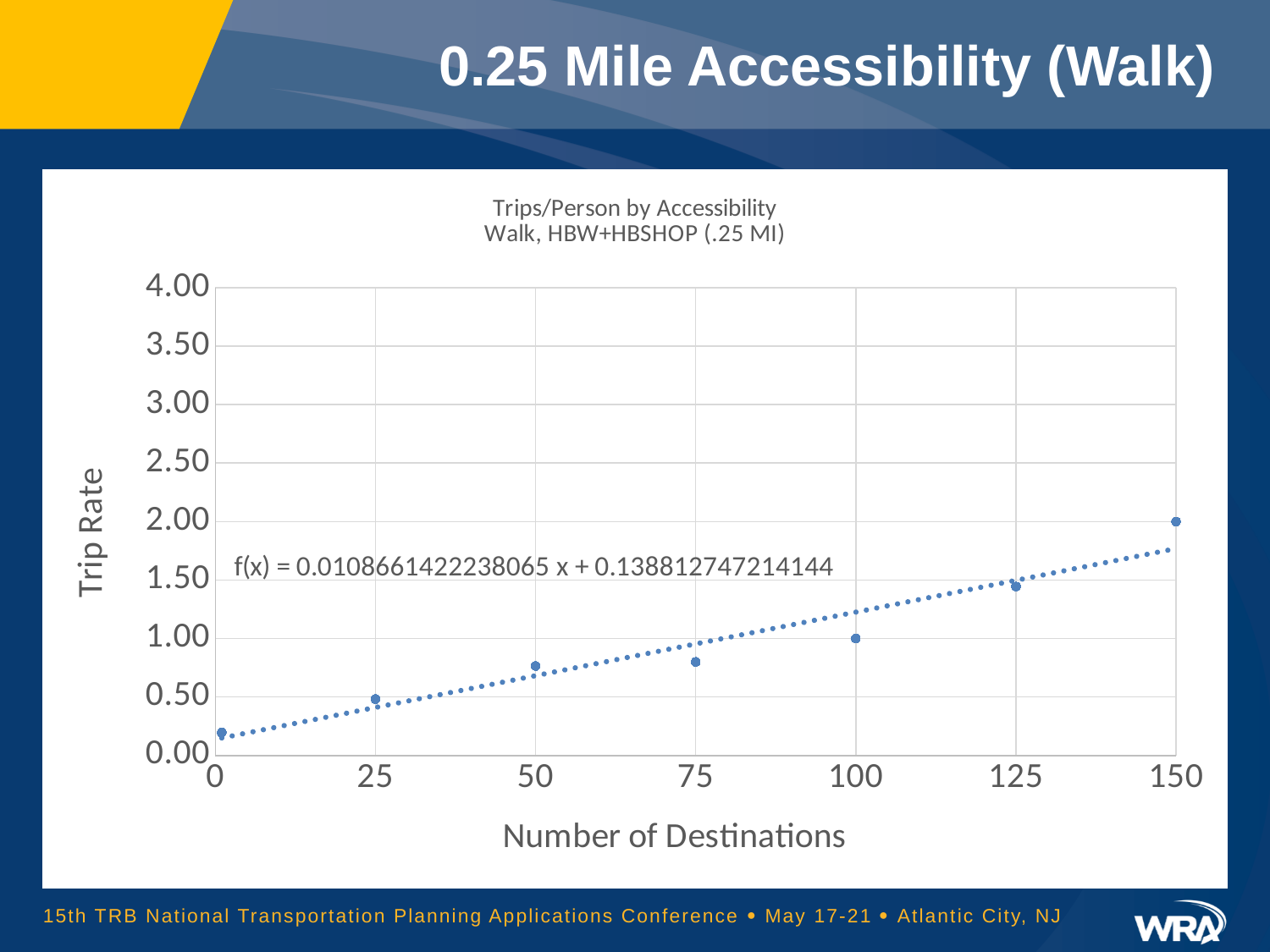
What is the title of the chart? Trips/Person by Accessibility Walk, HBW+HBSHOP (.25 MI) How many data points are plotted in the chart? 7 Is the trip rate at 0 destinations greater or less than 0.50? less Do the trip rate values rise or fall as the number of destinations increases? rise Is the trip rate at 125 destinations greater or less than 2.00? less Is the trip rate at 75 destinations greater or less than 1.00? less Which has the larger trip rate: 100 destinations or 150 destinations? 150 destinations What kind of chart is shown on the slide? scatter chart At which number of destinations is the trip rate highest? 150 What is the label of the x axis? Number of Destinations